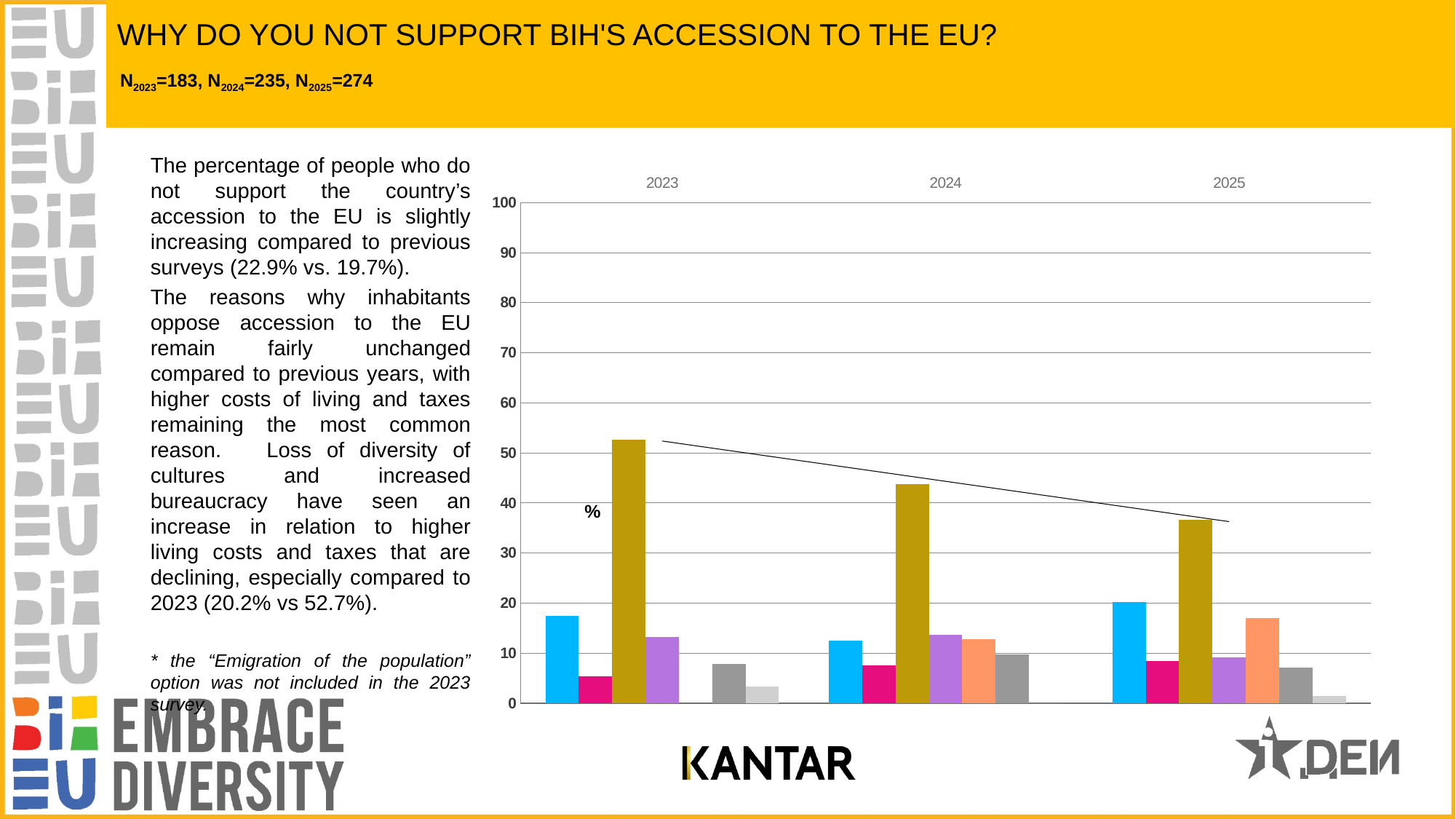
Which years are shown as categories on the x axis? 2023, 2024, 2025 What kind of chart is shown on the slide? bar chart How many year categories are shown along the x axis of the chart? 3 Is the value of the tallest (gold) bar for 2024 greater or less than 50? less What is the highest value shown on the chart's vertical axis? 100 Is the value of the tallest (gold) bar for 2025 greater or less than 40? less Is the value of the magenta bar for 2023 greater or less than 10? less Does the tallest (gold) bar rise or fall from 2023 to 2025? fall In which year does the chart's tallest bar appear? 2023